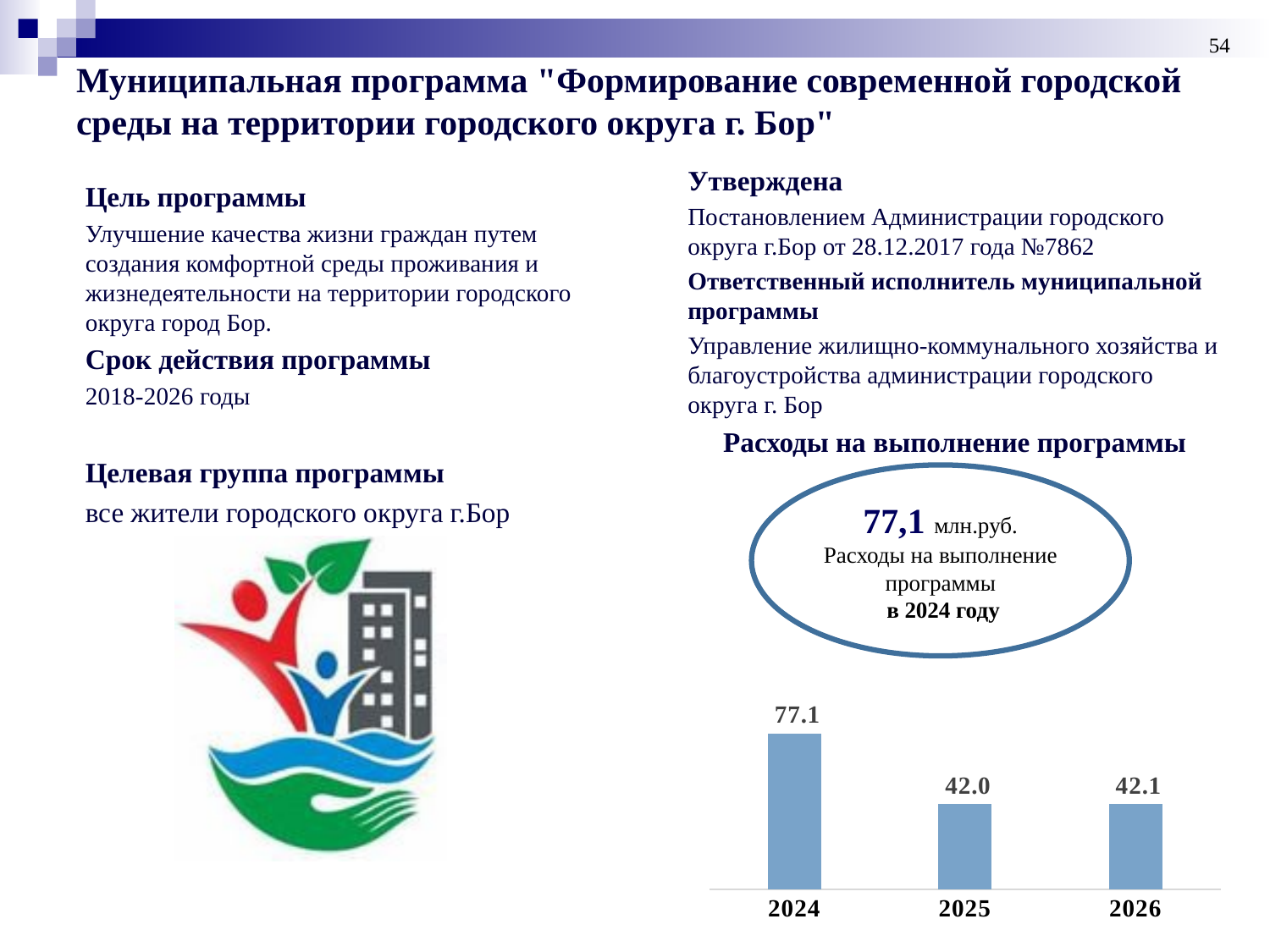
What is the difference between the values for 2026 and 2025 in the chart 'Расходы на выполнение программы'? 0.1 What is the difference between the values for 2024 and 2026 in the chart 'Расходы на выполнение программы'? 35.0 What is the title of the chart on the slide? Расходы на выполнение программы Which year has the highest value in the chart 'Расходы на выполнение программы'? 2024 Does the value fall or rise from 2024 to 2025 in the chart 'Расходы на выполнение программы'? Fall How many years (categories) are shown in the chart 'Расходы на выполнение программы'? 3 In the chart 'Расходы на выполнение программы', which is larger: the value for 2024 or the value for 2026? 2024 What is the value for 2025 in the chart 'Расходы на выполнение программы'? 42.0 What is the difference between the values for 2024 and 2025 in the chart 'Расходы на выполнение программы'? 35.1 What is the value for 2024 in the chart 'Расходы на выполнение программы'? 77.1 What kind of chart is 'Расходы на выполнение программы'? Bar chart What is the value for 2026 in the chart 'Расходы на выполнение программы'? 42.1